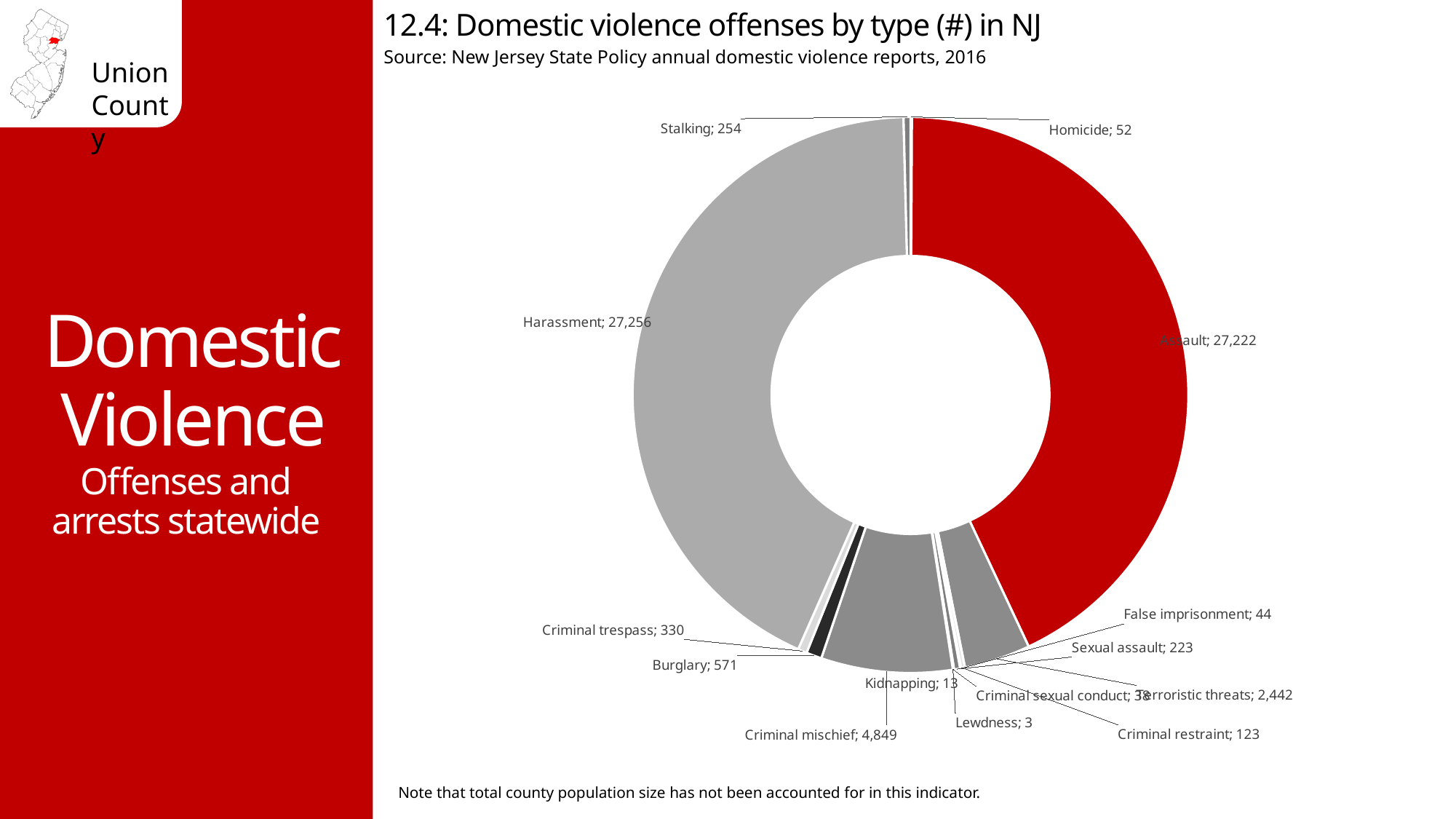
What value is shown for Homicide? 52 How many offense types are shown in the chart? 14 Which is larger, the value for Stalking or the value for Sexual assault? Stalking What is the difference between the Harassment and Assault values? 34 How many more Burglary offenses are there than Criminal trespass offenses? 241 What is the value for Burglary in the chart? 571 Which offense type has the lowest number in the chart? Lewdness How many Terroristic threats offenses does the chart show? 2,442 What is the value shown for Criminal restraint? 123 What is the number of Criminal mischief offenses shown in the chart? 4,849 What kind of chart is used on this slide? doughnut chart What year of data does the chart's source line cite? 2016